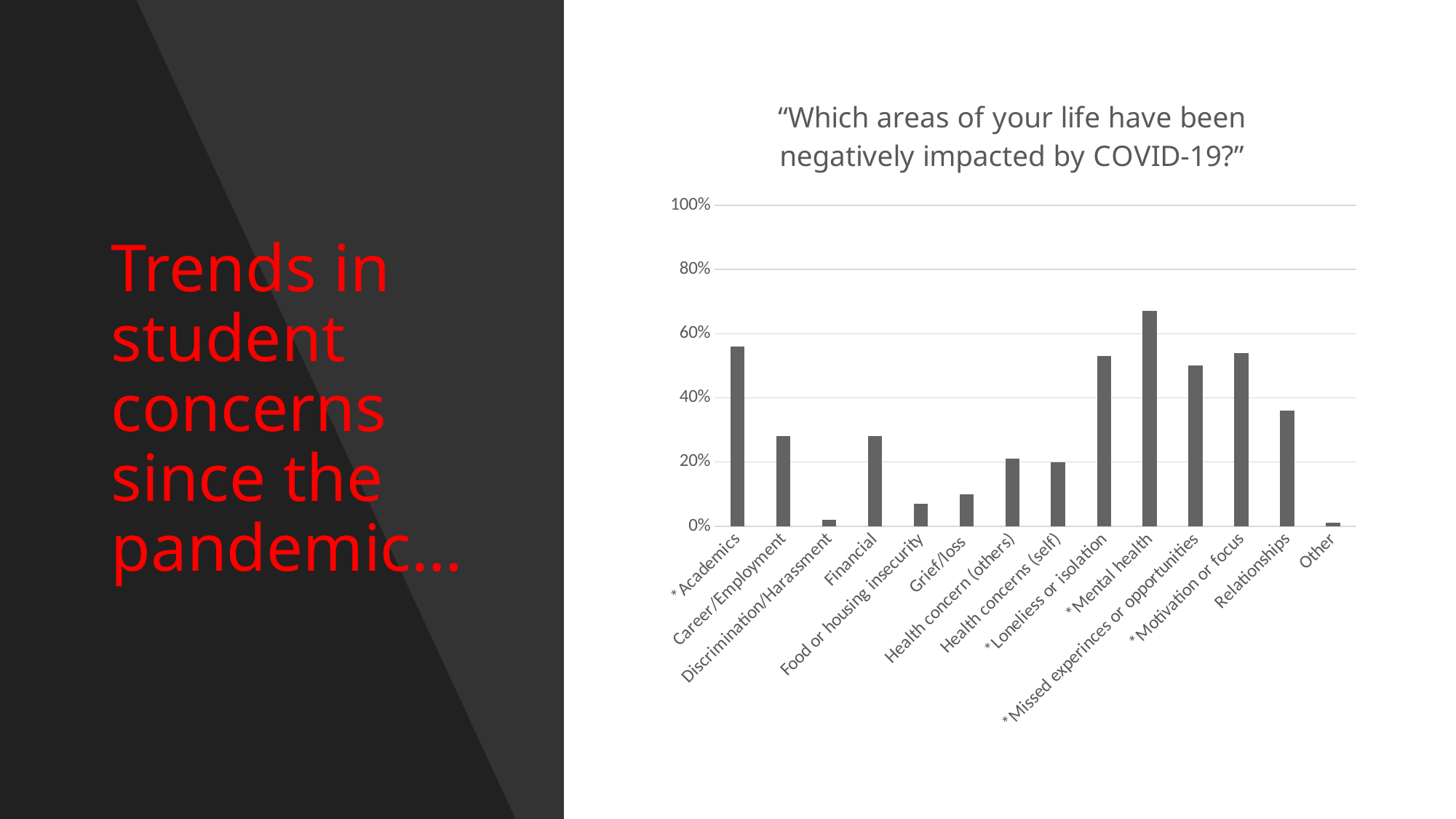
Is the value for Discrimination/Harassment greater or less than 20%? less Is the value for Relationships greater or less than 40%? less Is the value for Career/Employment greater or less than 20%? greater Which category has the highest value in the chart? *Mental health What kind of chart is shown on the slide? bar chart What is the title of the chart? "Which areas of your life have been negatively impacted by COVID-19?" Which is larger, the value for *Mental health or the value for *Academics? *Mental health Which is larger, the value for Relationships or the value for Grief/loss? Relationships How many categories are shown on the x axis of the chart? 14